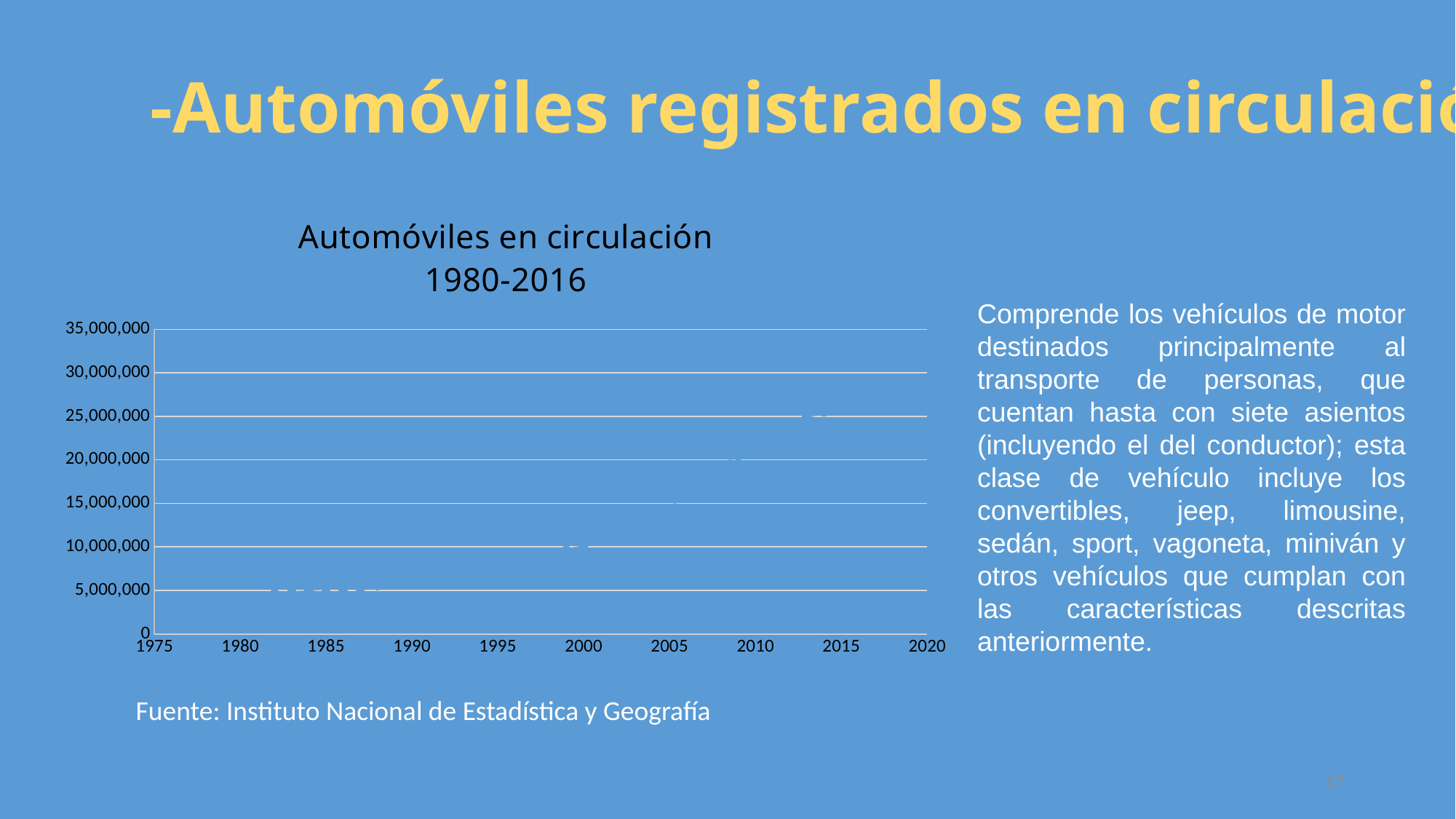
Is the value plotted around 2014 greater or less than 30,000,000? less Do the plotted values rise or fall as the years increase along the x axis? rise Is the value plotted around 2010 greater or less than 15,000,000? greater What is the highest value labelled on the chart's vertical axis? 35,000,000 Which is larger, the value plotted around 2005 or the value plotted around 1985? around 2005 Is the value plotted around 1985 greater or less than 10,000,000? less Which is larger, the value plotted around 2000 or the value plotted around 2010? around 2010 What is the title of the chart? Automóviles en circulación 1980-2016